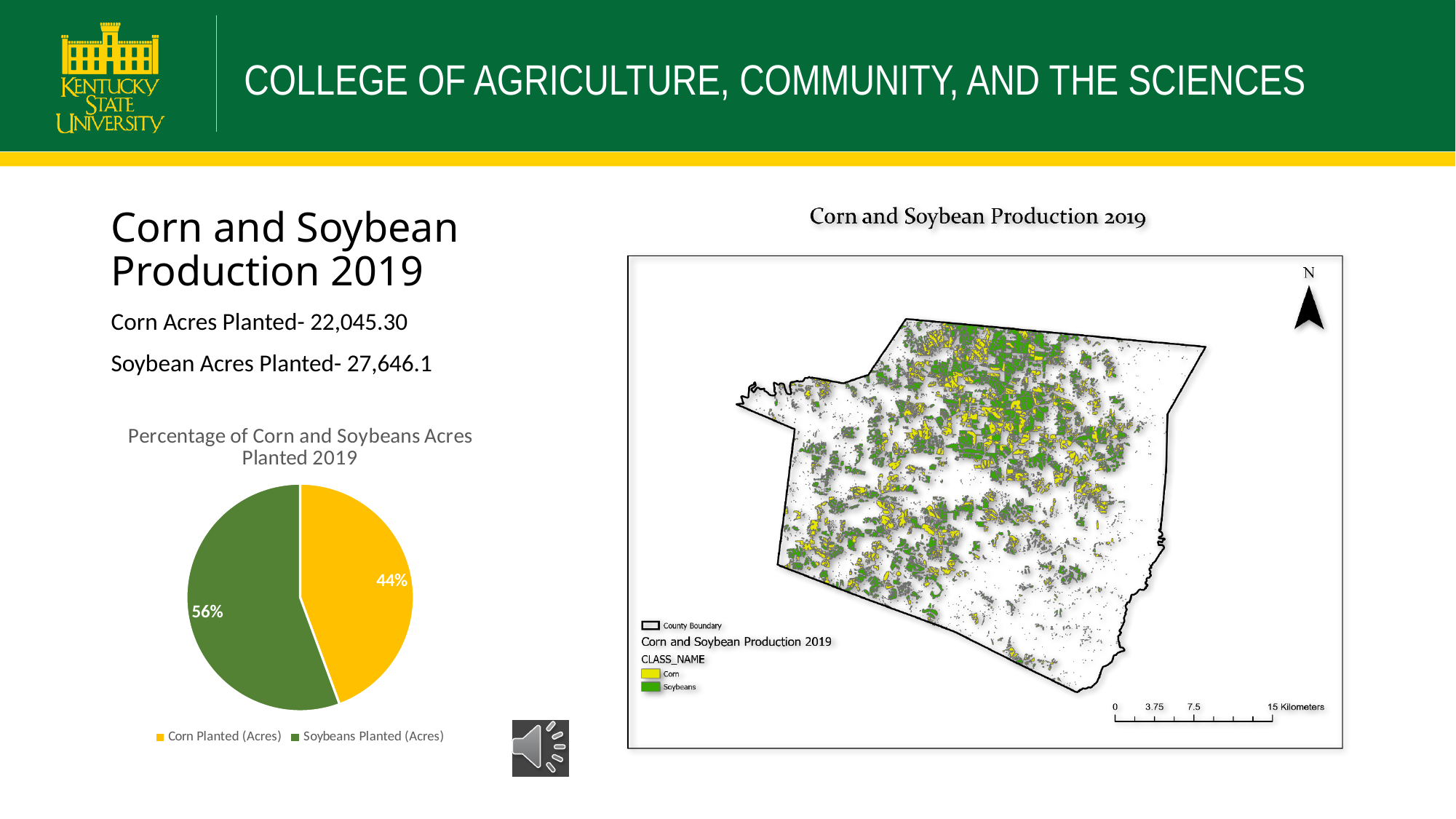
What colour is the Corn Planted (Acres) slice in the pie chart? Yellow Is the share for Soybeans Planted (Acres) greater or less than 50%? greater How many slices does the pie chart have? 2 What is the difference in percentage points between the Soybeans Planted slice and the Corn Planted slice? 12 What percentage of the pie chart is Corn Planted (Acres)? 44% Which slice of the pie chart is the largest? Soybeans Planted (Acres) What type of chart is shown on the slide? Pie chart How many entries does the pie chart legend list? 2 Which is larger in the pie chart, Corn Planted (Acres) or Soybeans Planted (Acres)? Soybeans Planted (Acres) What percentage of the pie chart is Soybeans Planted (Acres)? 56% What is the title of the pie chart? Percentage of Corn and Soybeans Acres Planted 2019 Which slice of the pie chart is the smallest? Corn Planted (Acres)